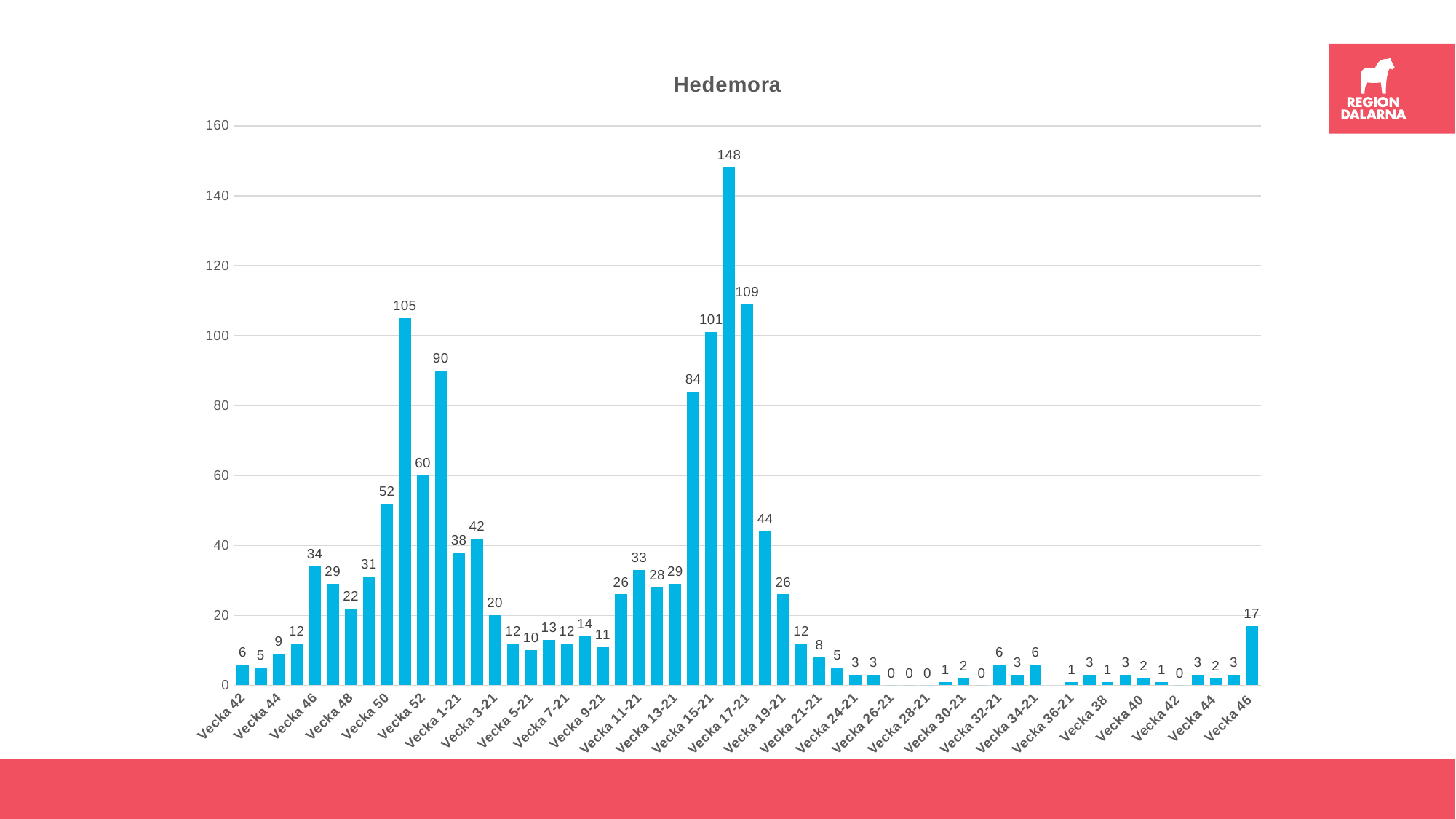
What is the difference between the values for Vecka 17-21 and Vecka 15-21? 8 What is the value for Vecka 50? 52 What is the value for Vecka 1-21? 38 What is the value for Vecka 15-21? 101 What is the highest value shown in the chart? 148 What is the value for Vecka 17-21? 109 What is the value of the rightmost bar, Vecka 46 at the end of the x axis? 17 Which has the larger value, Vecka 50 or Vecka 52? Vecka 52 What is the title of the chart? Hedemora What is the value of the leftmost bar, Vecka 42 at the start of the x axis? 6 What kind of chart is shown on the slide? bar chart What is the value for Vecka 52? 60